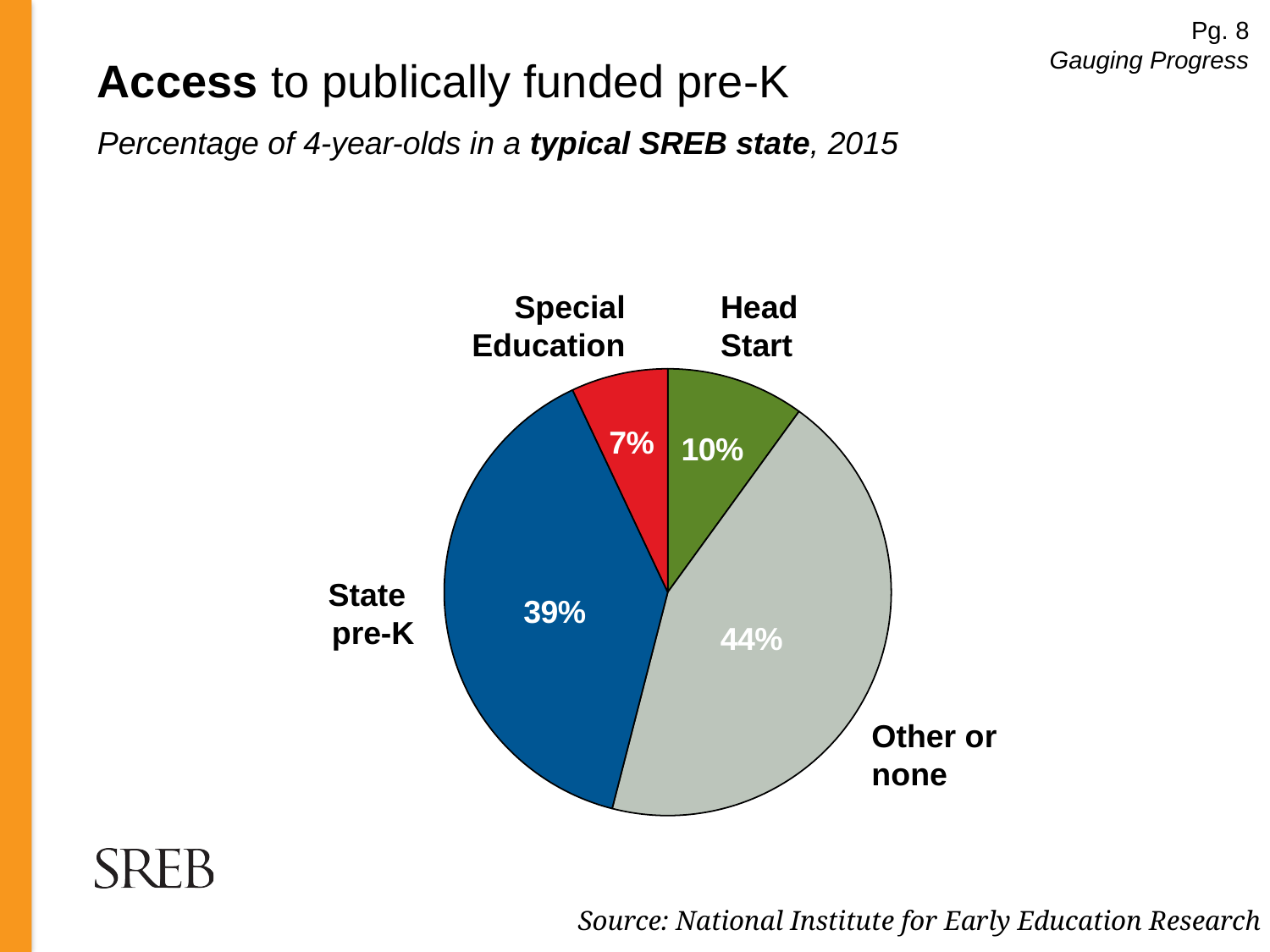
What percentage of 4-year-olds are in Special Education? 7% Which category has the smallest share of the pie? Special Education What is the difference in percentage points between Other or none and State pre-K? 5 Which category has the largest share of the pie? Other or none What colour is the State pre-K slice? blue What percentage of 4-year-olds are in the Other or none category? 44% What kind of chart is shown on the slide? pie chart What is the combined percentage of State pre-K and Head Start? 49% How many categories are shown in the pie chart? 4 What percentage of 4-year-olds are in State pre-K? 39% Which is larger, the share for Head Start or the share for Special Education? Head Start What percentage of 4-year-olds are in Head Start? 10%